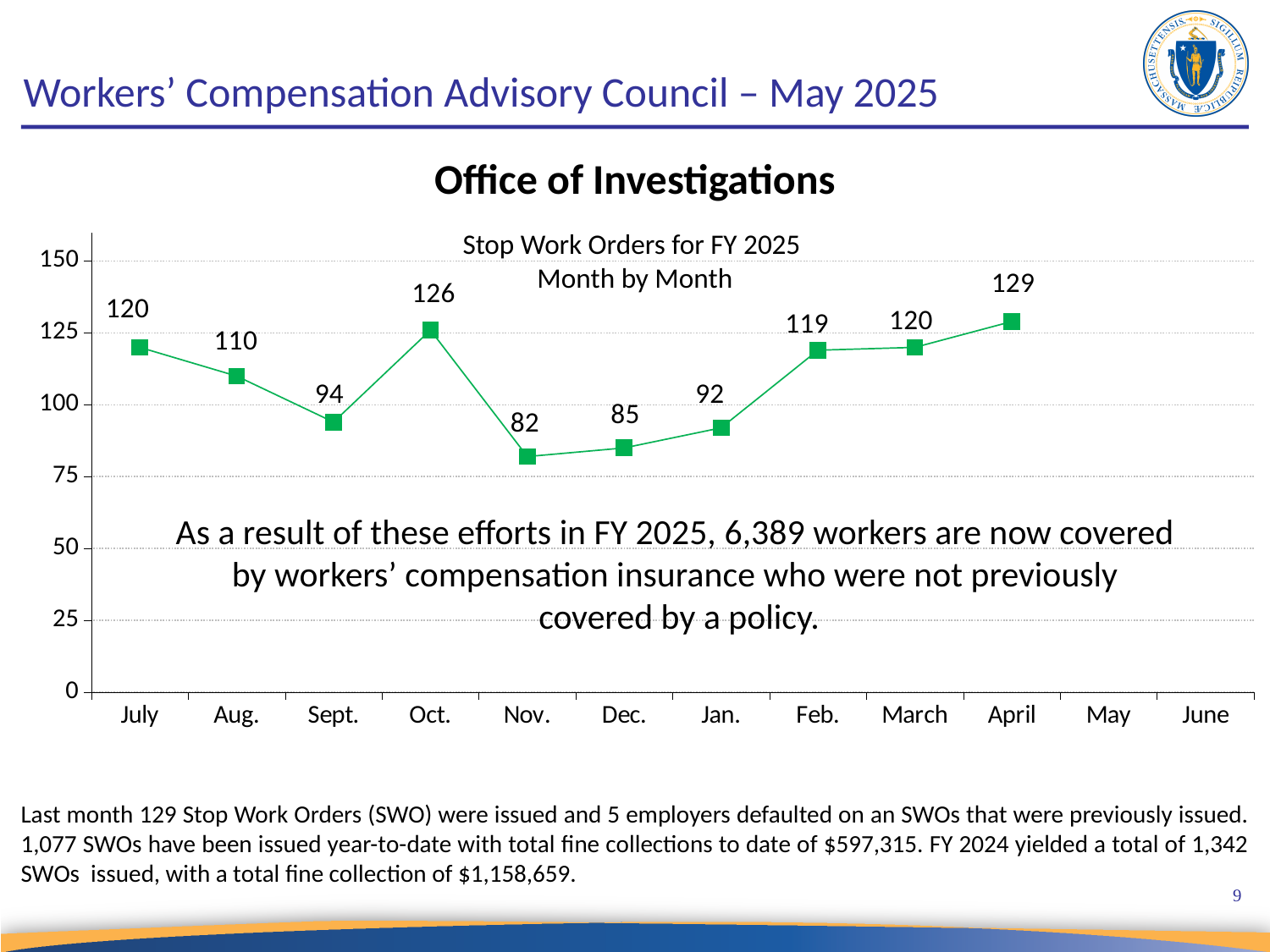
Which is larger, the value for Sept. or the value for Jan.? Sept. What is the difference between the values for July and Aug.? 10 Is the value for Dec. greater or less than 100? less Do the values rise or fall from Nov. to April? rise How many Stop Work Orders were issued in Nov. according to the chart? 82 What is the value plotted for Feb.? 119 What kind of chart is shown on the slide? line chart What is the difference between the values for April and Nov.? 47 Which month has the lowest value in the chart? Nov. What is the value for Oct. in the Stop Work Orders for FY 2025 chart? 126 How many months have a data point plotted on the line? 10 Which month has the highest value in the chart? April